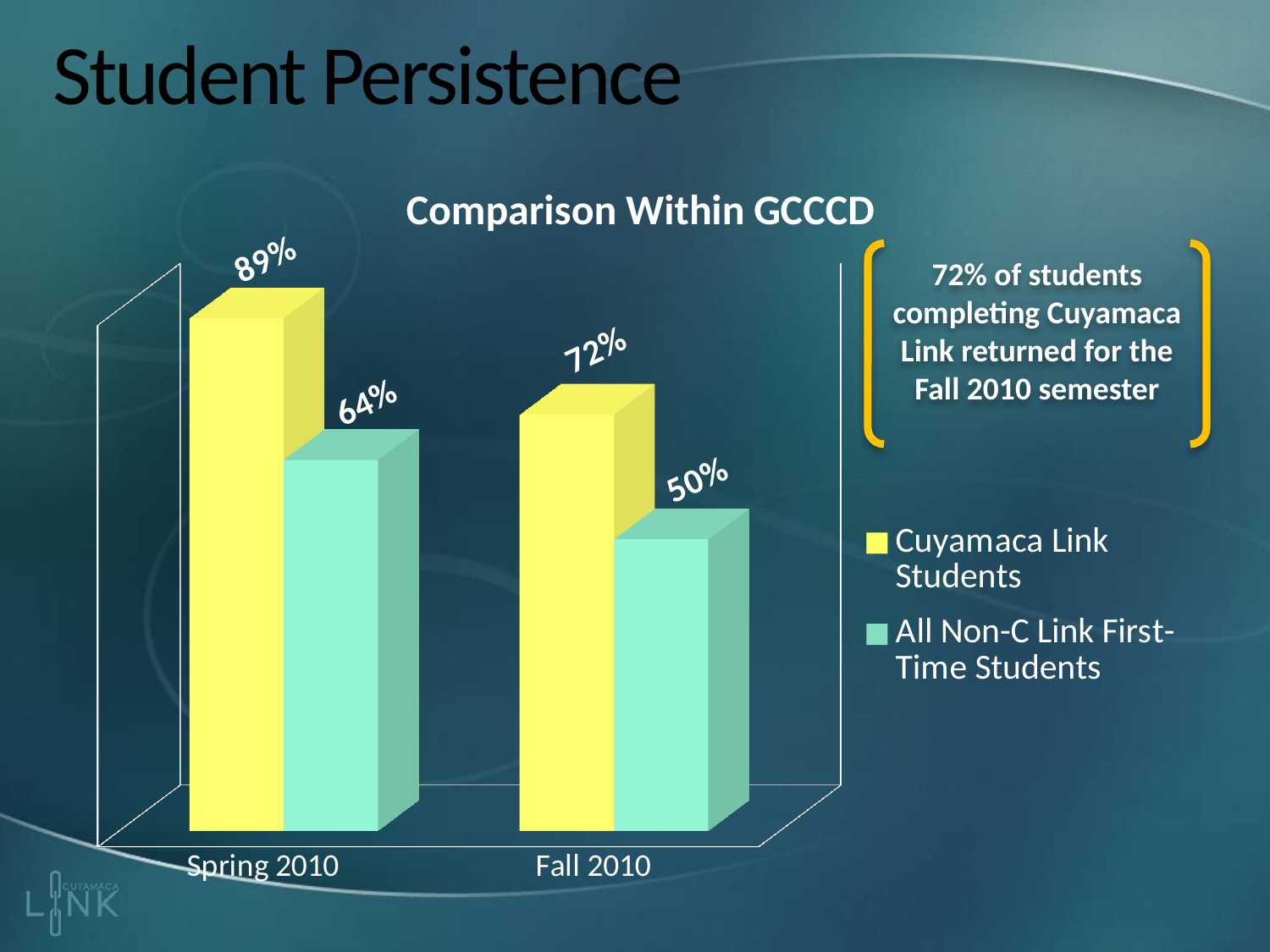
Which series has the highest value in Spring 2010? Cuyamaca Link Students What is the difference between Cuyamaca Link Students and All Non-C Link First-Time Students in Spring 2010? 25% What kind of chart is shown on the slide? Bar chart What is the difference between Cuyamaca Link Students and All Non-C Link First-Time Students in Fall 2010? 22% How many categories are shown on the x axis? 2 What is the value for Cuyamaca Link Students in Spring 2010? 89% Which series has the lowest value in Fall 2010? All Non-C Link First-Time Students How many series does the legend list? 2 What is the value for Cuyamaca Link Students in Fall 2010? 72% Which is larger: Cuyamaca Link Students in Fall 2010 or All Non-C Link First-Time Students in Spring 2010? Cuyamaca Link Students in Fall 2010 What is the value for All Non-C Link First-Time Students in Spring 2010? 64% What is the value for All Non-C Link First-Time Students in Fall 2010? 50%